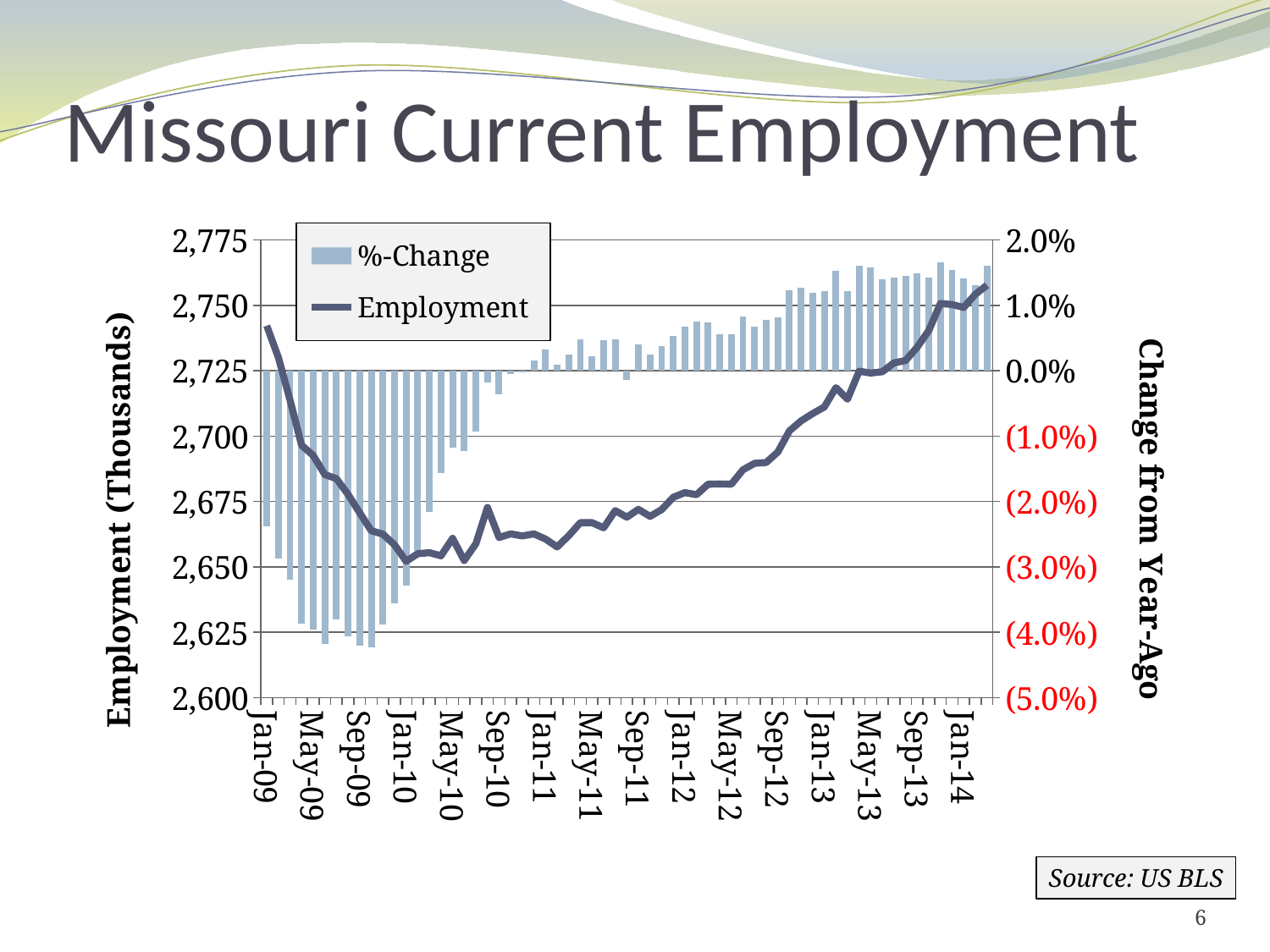
What kind of chart is shown on the slide? A combined bar and line chart Is the %-Change bar for Sep-09 greater or less than (3.0%)? less How does the Employment line move from Jan-09 to Jan-14? It falls through 2009, bottoms out around early 2010, then rises What are the two series named in the legend? %-Change and Employment Which is larger, the Employment value at Jan-09 or at Jan-10? Jan-09 Is the Employment value for Jan-14 greater or less than 2,725? greater How many series does the legend list? 2 Is the Employment value for Jan-09 greater or less than 2,725? greater Which is larger, the Employment value at Jan-14 or at Jan-09? Jan-14 What is the title of the left vertical axis? Employment (Thousands)